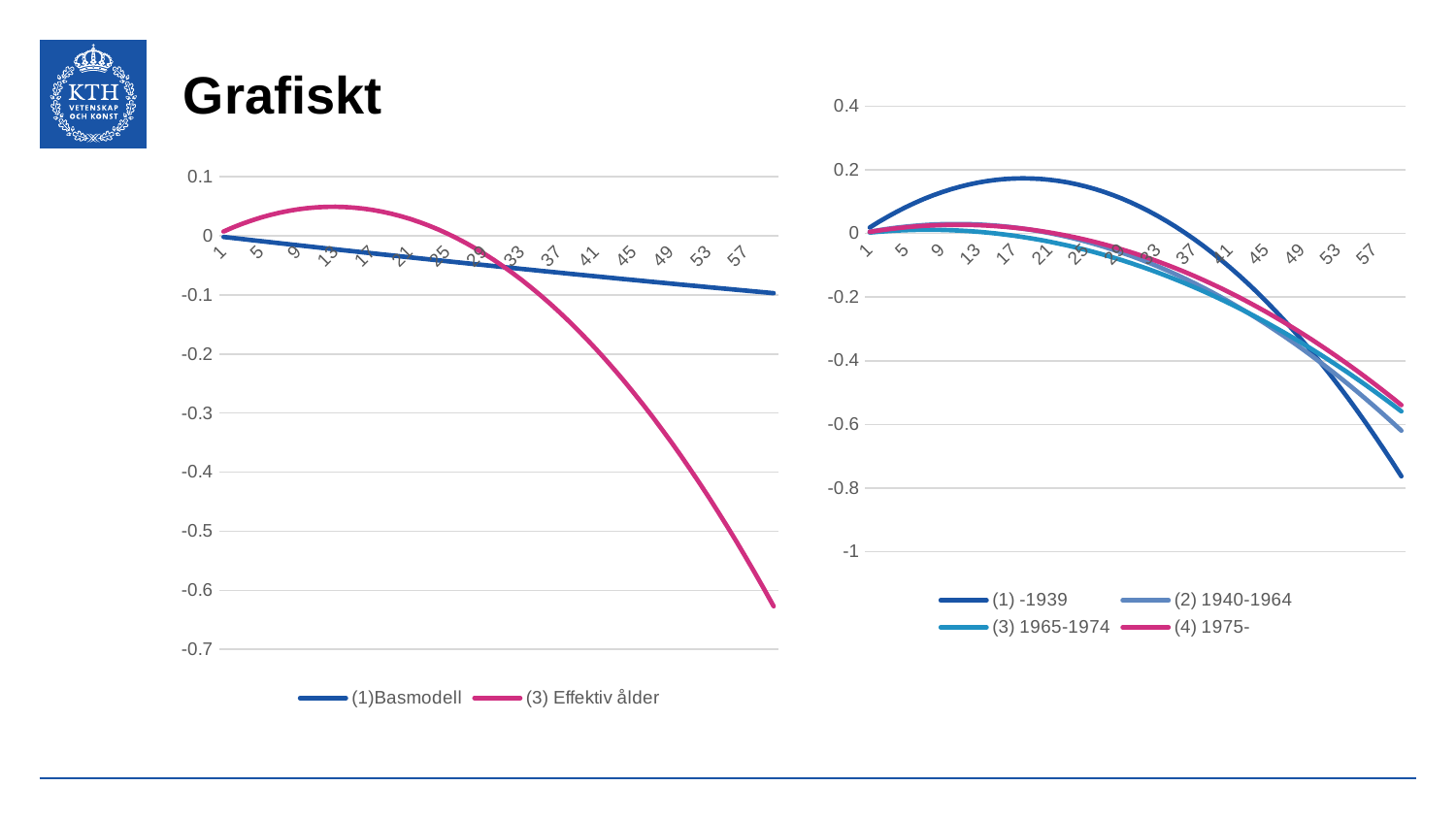
In the right chart, is the value of (4) 1975- at x = 57 greater or less than -0.6? greater In the left chart, is the value of (1)Basmodell at x = 57 greater or less than -0.2? greater In the right chart, which series is drawn in pink? (4) 1975- How many series does the legend of the left chart list? 2 In the left chart, is the value of (3) Effektiv ålder at x = 57 greater or less than -0.6? greater In the left chart, which series has the lower value at x = 57, (1)Basmodell or (3) Effektiv ålder? (3) Effektiv ålder In the right chart, which series has the lowest value at x = 57? (1) -1939 What kind of chart is the chart on the left of the slide? line chart In the left chart, does the (1)Basmodell line rise or fall as x increases? fall How many series does the legend of the right chart list? 4 What kind of chart is the chart on the right of the slide? line chart